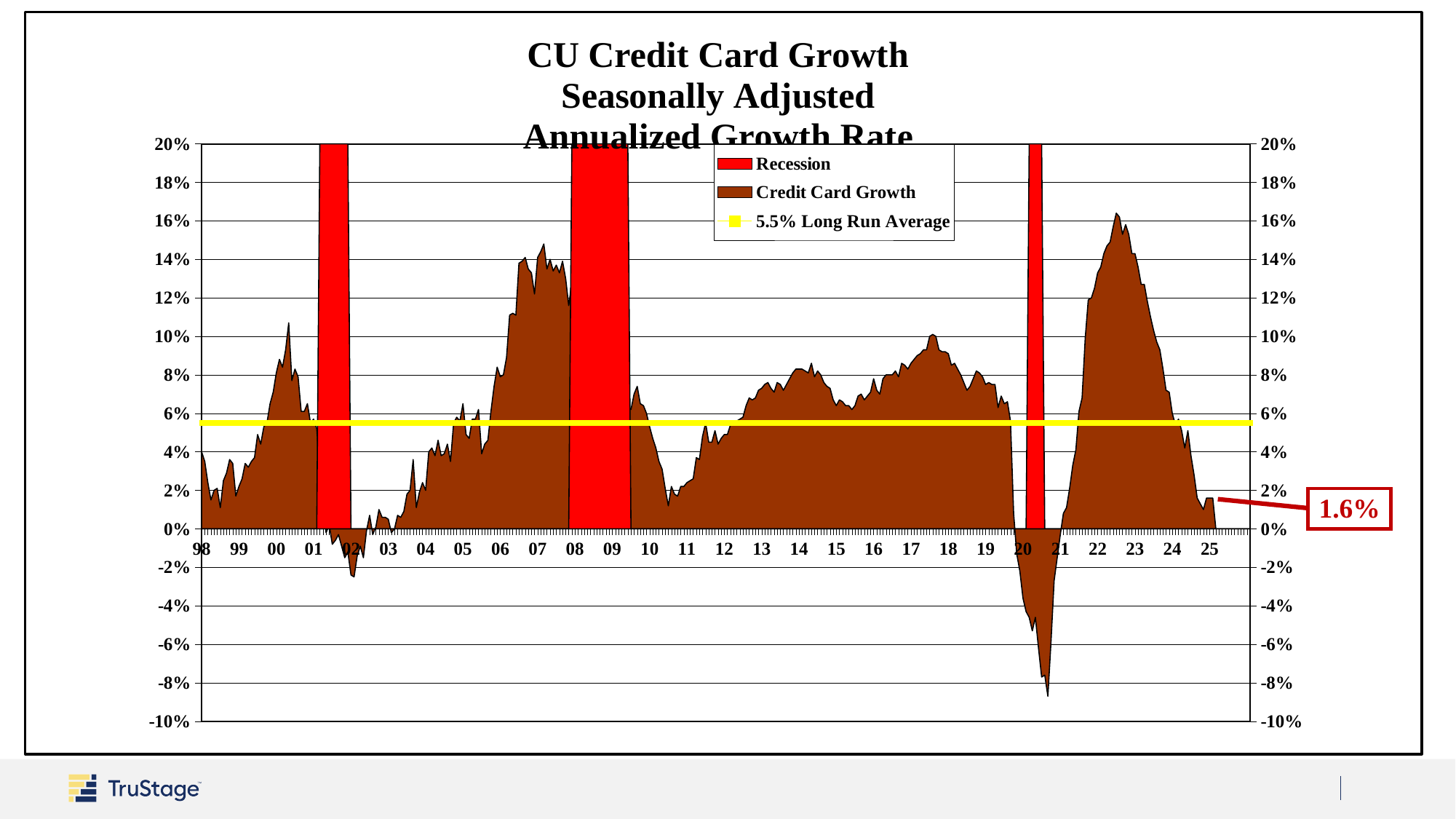
Do credit card growth values rise or fall from 2023 to 2025? fall Is the lowest credit card growth value around 2020 greater or less than -6%? less How many entries does the legend list? 3 What is the most recent credit card growth value called out on the chart? 1.6% What kind of chart is shown on the slide? area chart What is the highest value shown on the y axis? 20% Is the most recent value of 1.6% greater or less than the 5.5% long run average? less How many recession periods are shaded on the chart? 3 What colour are the recession bars on the chart? red Is the peak credit card growth around 2022 greater or less than 14%? greater Is the peak around 2022 higher or lower than the peak around 2007? higher What is the long run average growth rate shown by the yellow line? 5.5%